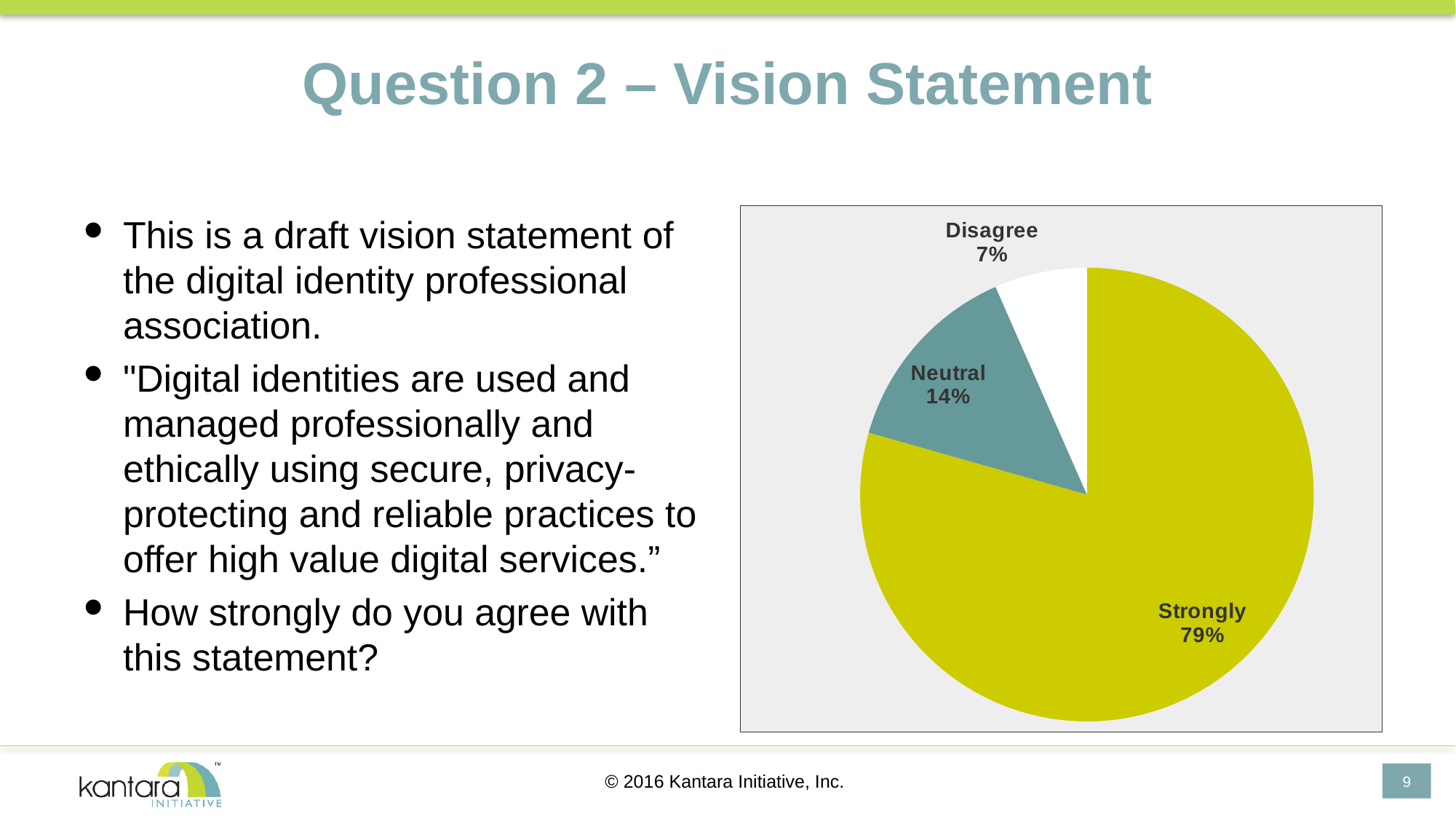
Which slice of the pie is the largest? Strongly Which slice of the pie is the smallest? Disagree Which is larger, the Neutral slice or the Disagree slice? Neutral What is the difference in percentage points between the Neutral slice and the Disagree slice? 7 What colour is the Strongly slice of the pie? yellow-green What percentage of the pie is labelled Neutral? 14% How many slices does the pie chart have? 3 What is the title of the slide containing the pie chart? Question 2 – Vision Statement What is the difference in percentage points between the Strongly slice and the Neutral slice? 65 What percentage of the pie is labelled Strongly? 79% What kind of chart is shown on the slide? pie chart What percentage of the pie is labelled Disagree? 7%